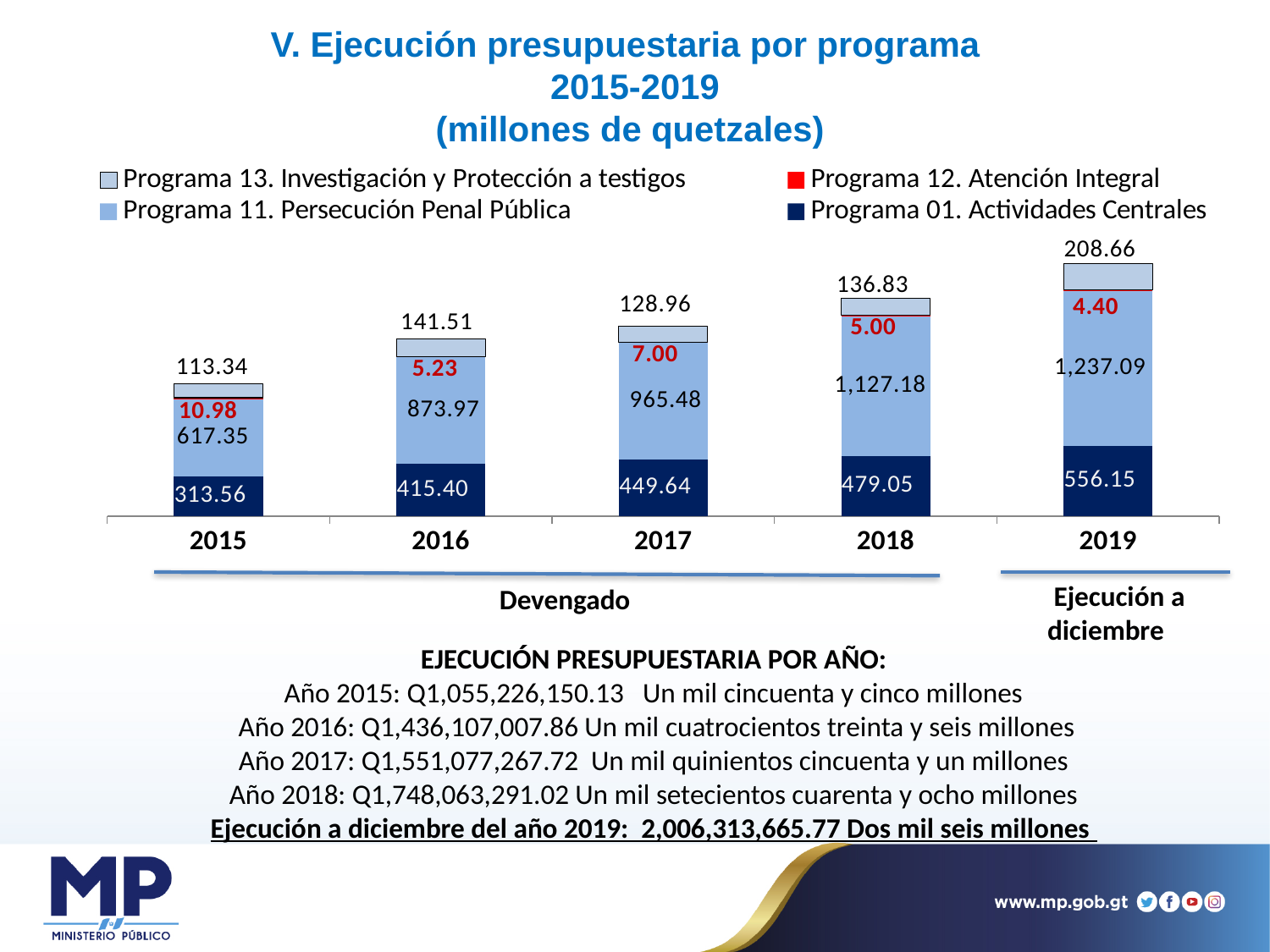
What kind of chart is shown on the slide? Stacked bar chart What is the value for Programa 12. Atención Integral in 2015? 10.98 What is the value for Programa 01. Actividades Centrales in 2019? 556.15 In which year is the value for Programa 12. Atención Integral lowest? 2019 How many series does the legend list? 4 What is the value for Programa 11. Persecución Penal Pública in 2017? 965.48 How many years are shown on the x axis? 5 In which year is the value for Programa 11. Persecución Penal Pública highest? 2019 Which is larger: Programa 13. Investigación y Protección a testigos in 2016 or in 2017? 2016 What is the difference between the Programa 01. Actividades Centrales values for 2019 and 2015? 242.59 What is the total of the stacked bar for 2018? 1,748.06 What is the value for Programa 13. Investigación y Protección a testigos in 2018? 136.83